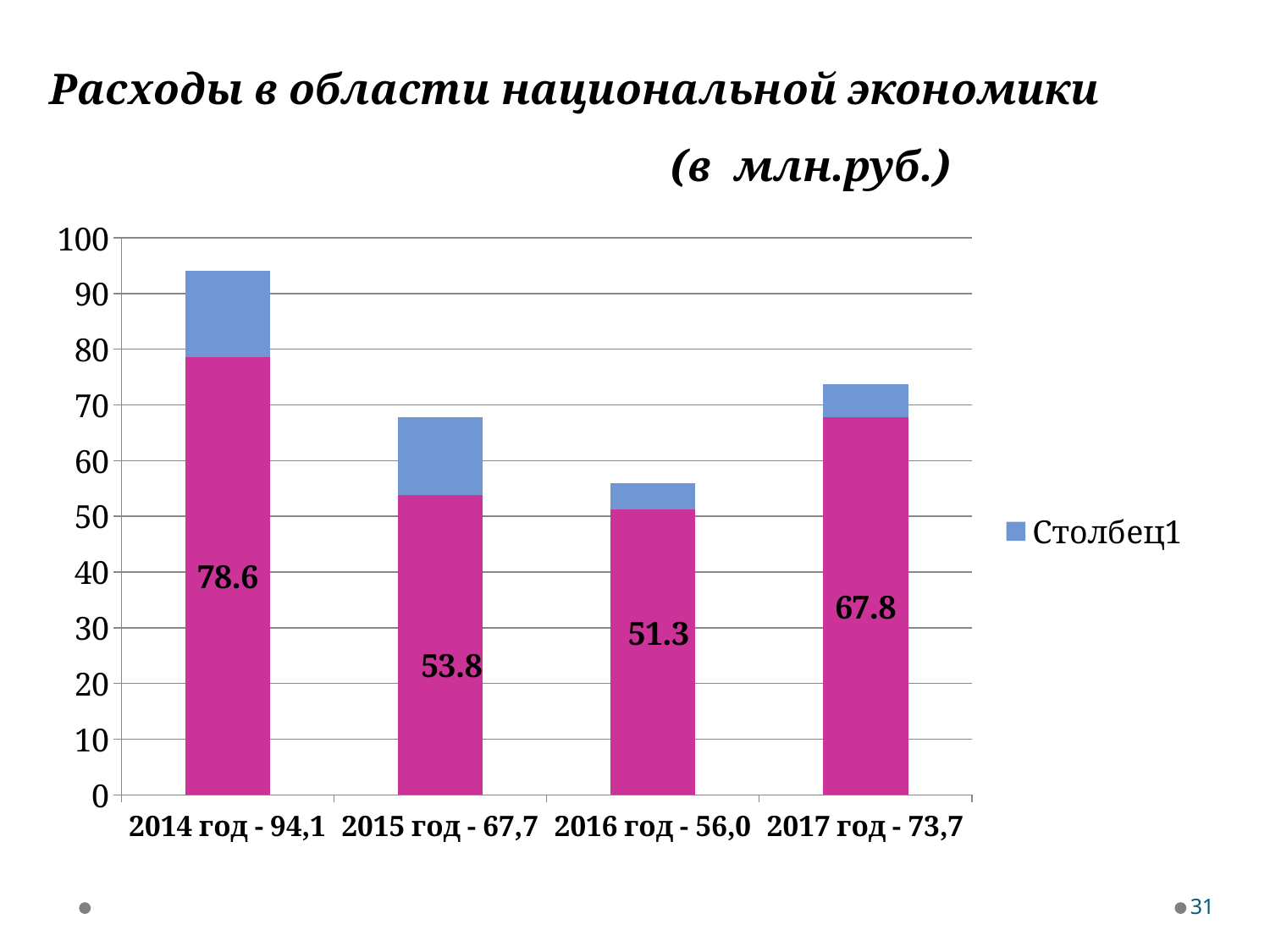
What is the only entry listed in the chart legend? Столбец1 Is the total height of the 2016 год bar greater or less than 60? less What type of chart is shown on the slide? Stacked bar chart How many years are shown on the x axis? 4 What is the value of the magenta segment for 2014 год? 78.6 Which is larger, the magenta segment value for 2015 год or for 2017 год? 2017 год Which year has the lowest magenta segment value? 2016 год What is the difference between the magenta segment values for 2014 год and 2015 год? 24.8 Which year has the highest magenta segment value? 2014 год What is the value of the magenta segment for 2017 год? 67.8 What is the value of the magenta segment for 2016 год? 51.3 Is the total height of the 2014 год bar greater or less than 90? greater